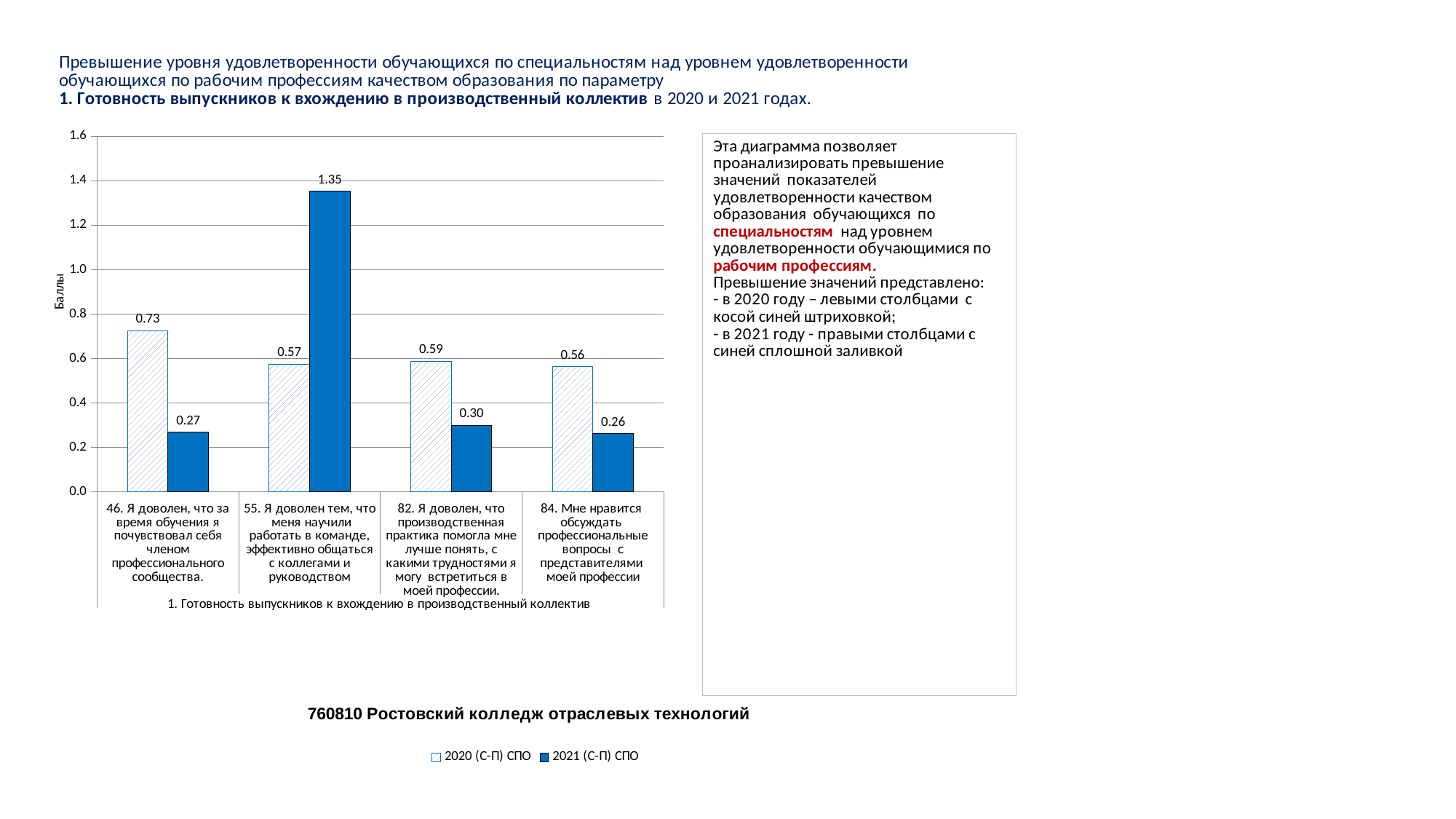
For category 82, which series has the larger value, 2020 (С-П) СПО or 2021 (С-П) СПО? 2020 (С-П) СПО How many series does the legend list? 2 What is the value for the 2021 (С-П) СПО series for category 84 ("Мне нравится обсуждать профессиональные вопросы...")? 0.26 What is the value for the 2020 (С-П) СПО series for category 46 ("Я доволен, что за время обучения я почувствовал себя членом профессионального сообщества")? 0.73 What is the value for the 2021 (С-П) СПО series for category 55 ("Я доволен тем, что меня научили работать в команде...")? 1.35 How many categories are shown on the x axis of the chart? 4 What is the difference between the 2020 and 2021 values for category 46? 0.46 Which category has the lowest value in the 2021 (С-П) СПО series? 84. Мне нравится обсуждать профессиональные вопросы с представителями моей профессии What kind of chart is shown on the slide? Bar chart What is the difference between the 2021 and 2020 values for category 55? 0.78 Which category has the highest value in the 2020 (С-П) СПО series? 46. Я доволен, что за время обучения я почувствовал себя членом профессионального сообщества. What is the label of the vertical axis of the chart? Баллы